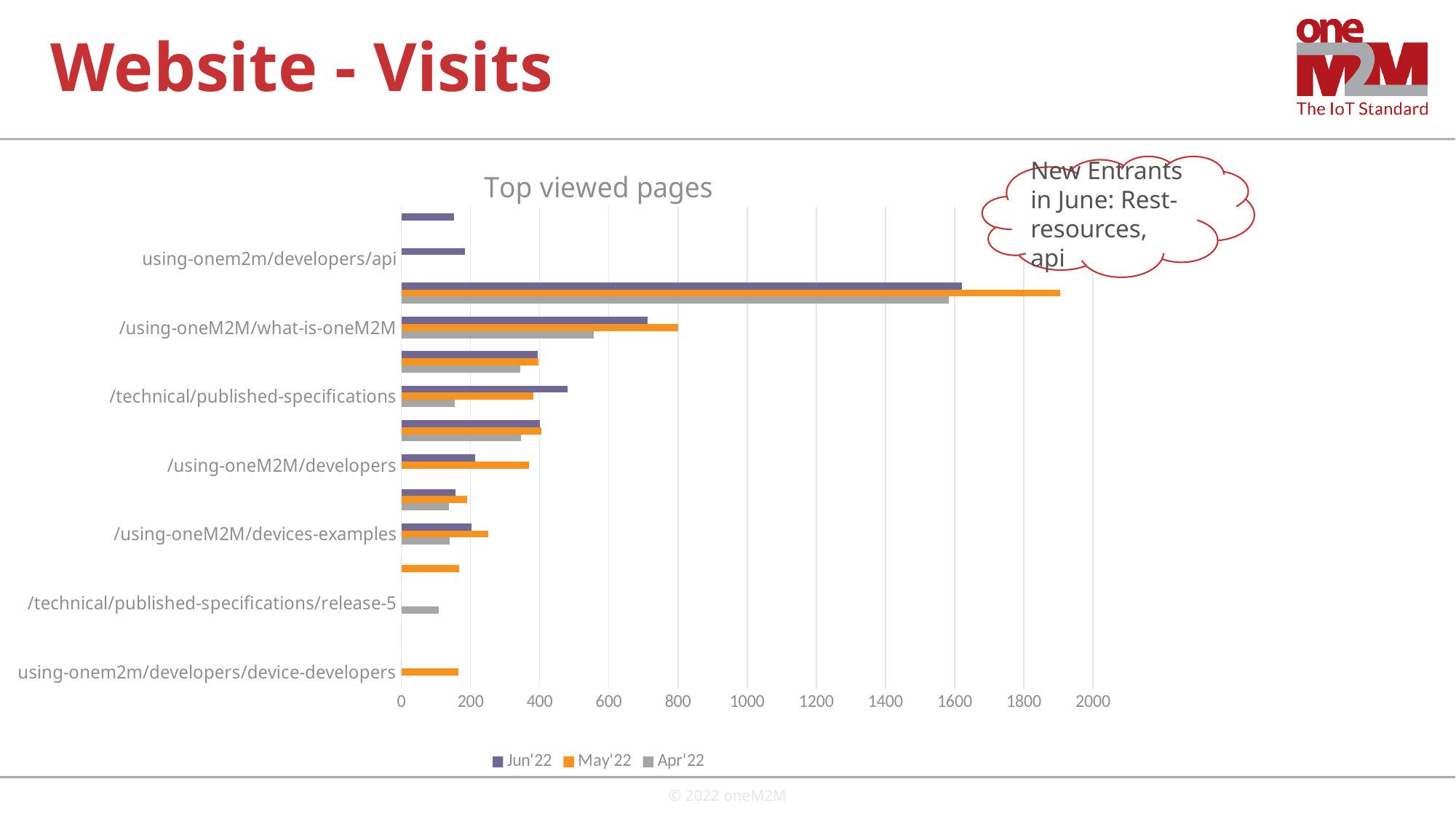
Is the May'22 value for using-onem2m/developers/device-developers greater or less than 200? less How many series does the legend list? 3 Which series are listed in the chart legend? Jun'22, May'22, Apr'22 What kind of chart is shown on the slide? bar chart Is the longest bar in the chart greater or less than 1800? greater What is the highest value shown on the horizontal axis? 2000 Which series has the single longest bar in the chart? May'22 Is the Apr'22 value for /technical/published-specifications/release-5 greater or less than 200? less What is the title of the chart? Top viewed pages